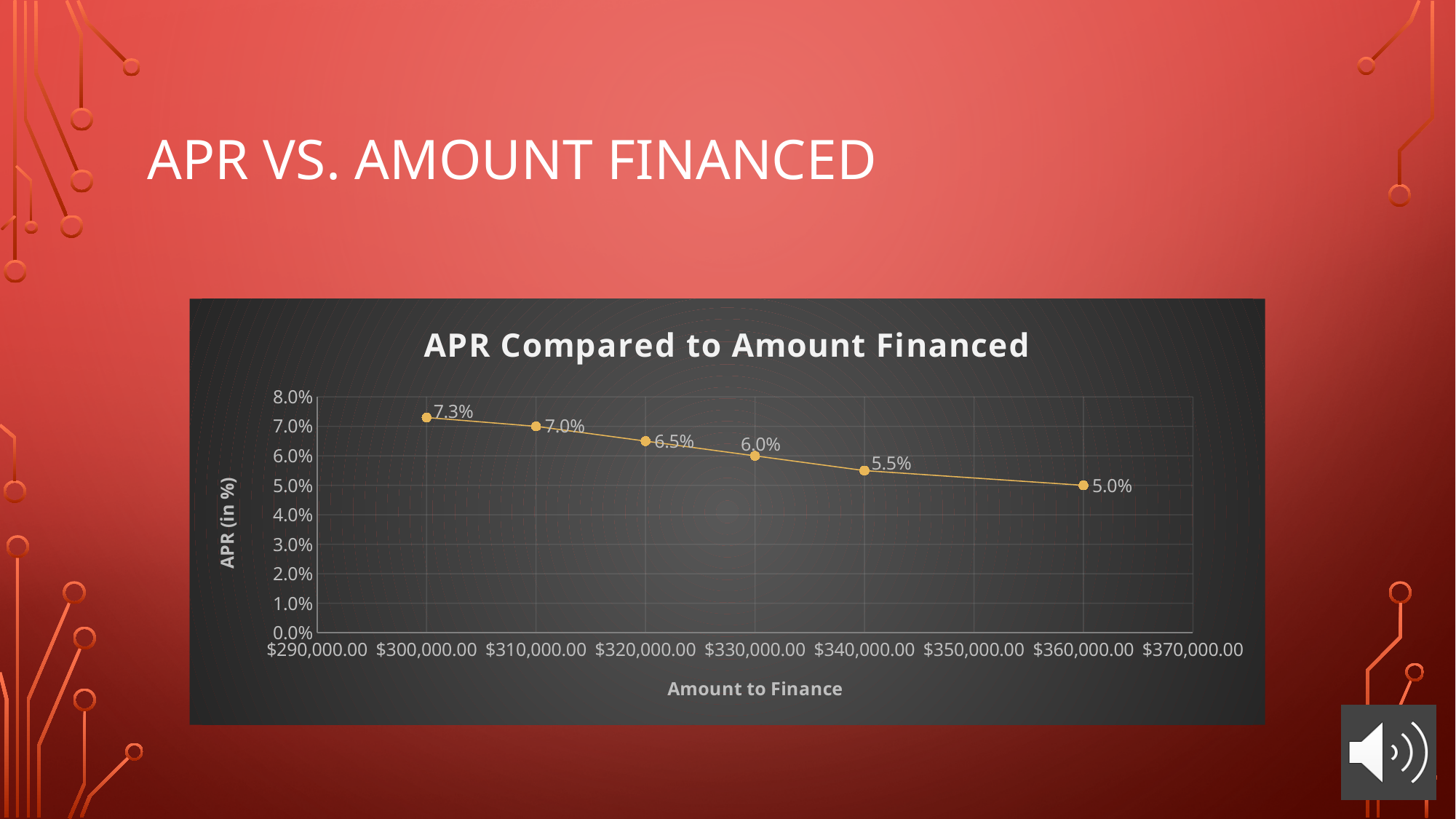
What type of chart is shown on the slide? line chart How many data points are plotted on the chart? 6 What is the APR at an amount financed of $360,000.00? 5.0% Which is larger, the APR at $310,000.00 or the APR at $340,000.00? $310,000.00 What is the difference between the highest and lowest APR values plotted? 2.3% Which amount financed has the lowest APR? $360,000.00 Does the APR rise or fall as the amount to finance increases? fall What is the APR at an amount financed of $300,000.00? 7.3% Which amount financed has the highest APR? $300,000.00 What is the APR at an amount financed of $330,000.00? 6.0% What is the title of the chart? APR Compared to Amount Financed What is the label of the vertical axis? APR (in %)